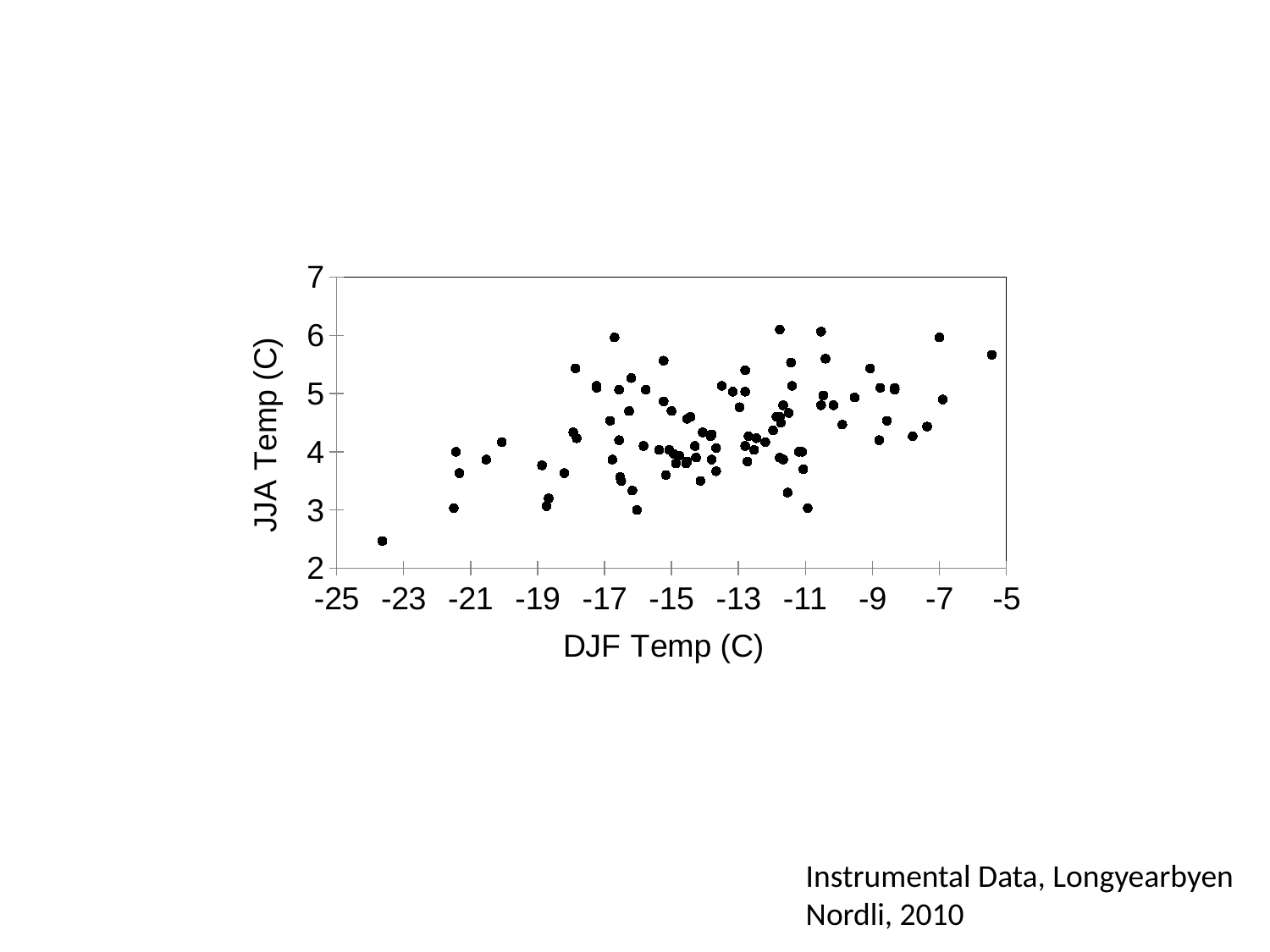
Is the DJF Temp of the rightmost point greater or less than -7? greater Do the JJA Temp values generally rise or fall as DJF Temp increases along the x axis? rise What is the label of the y axis? JJA Temp (C) Is the JJA Temp of the leftmost point greater or less than 4? less Is the JJA Temp of the rightmost point (near -5.5 DJF Temp) greater or less than 5? greater What is the label of the x axis? DJF Temp (C) What kind of chart is shown on the slide? scatter plot